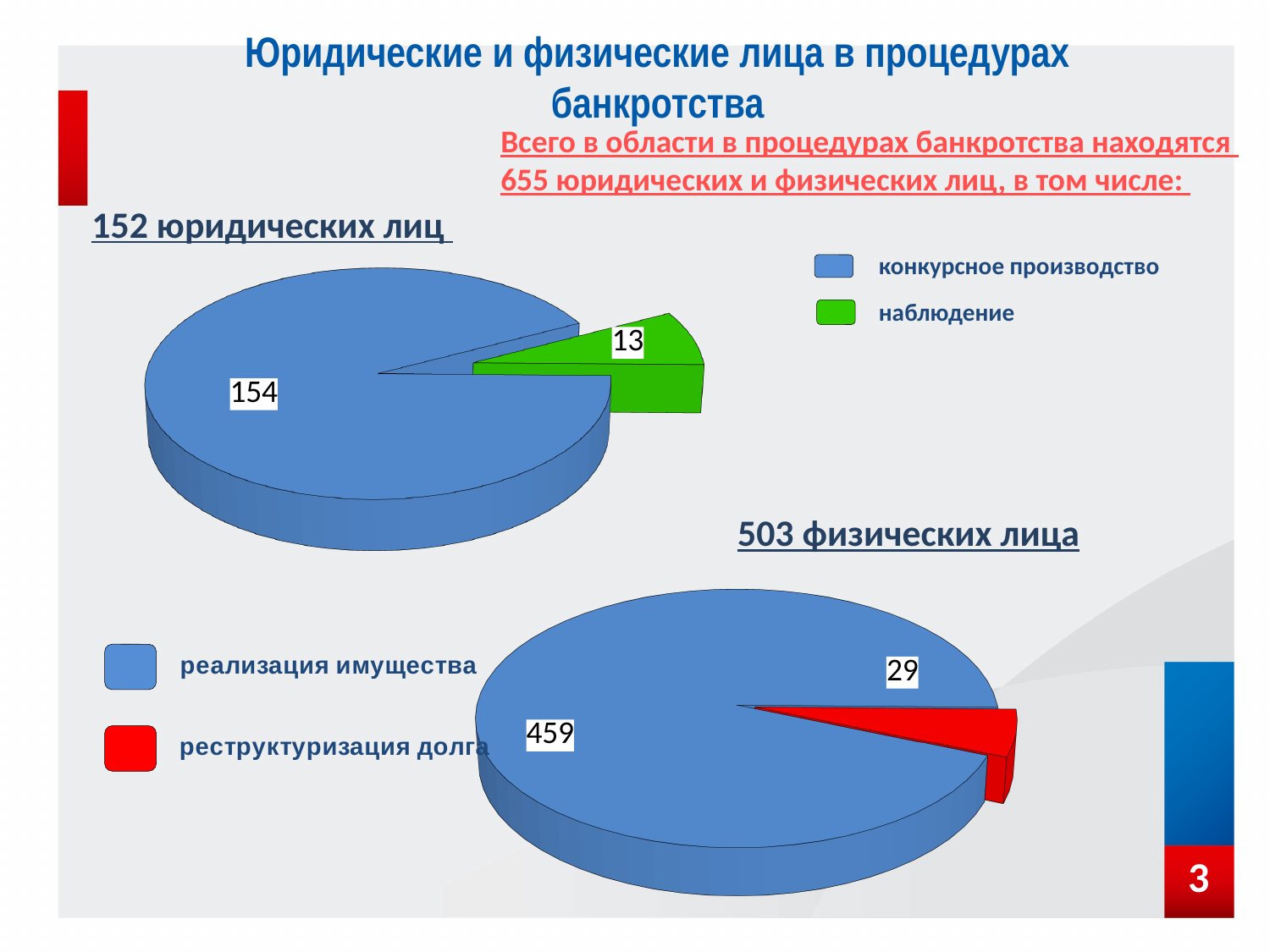
In the pie chart titled "503 физических лица", what is the value of the "реализация имущества" slice? 459 In the pie chart titled "503 физических лица", which is larger: "реализация имущества" or "реструктуризация долга"? реализация имущества In the pie chart titled "503 физических лица", what colour is the "реструктуризация долга" slice? Red In the pie chart titled "152 юридических лиц", which category has the largest slice? конкурсное производство How many slices does the pie chart titled "152 юридических лиц" have? 2 In the pie chart titled "152 юридических лиц", what is the difference between the "конкурсное производство" and "наблюдение" values? 141 In the pie chart titled "503 физических лица", what is the value of the "реструктуризация долга" slice? 29 In the pie chart titled "152 юридических лиц", what is the value of the "наблюдение" slice? 13 In the pie chart titled "503 физических лица", what is the difference between the "реализация имущества" and "реструктуризация долга" values? 430 What type of chart is used for "503 физических лица"? Pie chart In the pie chart titled "503 физических лица", which category has the smallest slice? реструктуризация долга In the pie chart titled "152 юридических лиц", what is the value of the "конкурсное производство" slice? 154